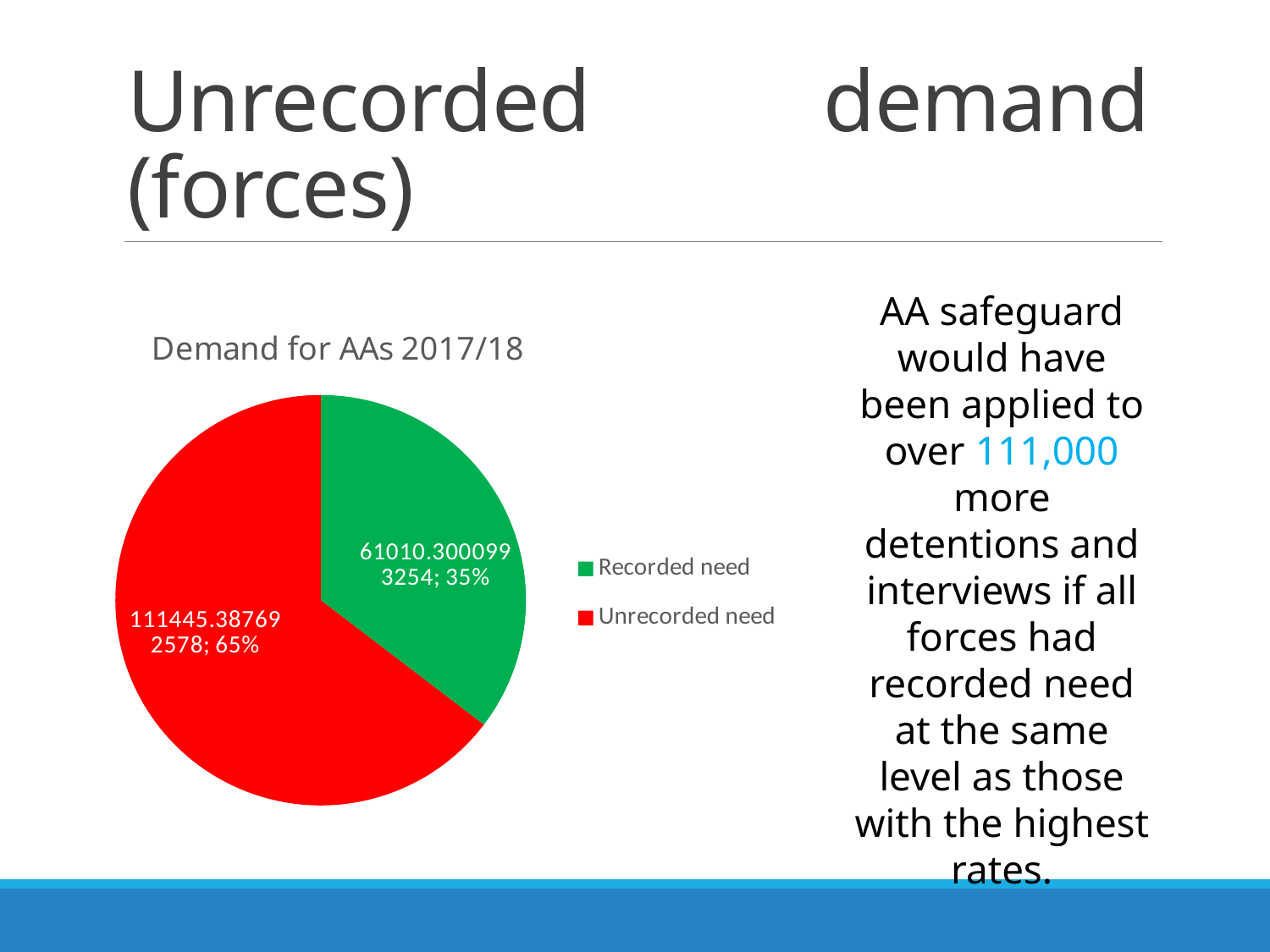
Which slice is the smallest in the pie chart? Recorded need What kind of chart is shown on the slide? pie chart What is the title of the chart? Demand for AAs 2017/18 How many slices does the pie chart have? 2 Which is larger, Recorded need or Unrecorded need? Unrecorded need What share of the pie does Unrecorded need represent? 65% What value is shown for Recorded need? 61010.3000993254 What value is shown for Unrecorded need? 111445.387692578 What colour is the Recorded need slice? green What share of the pie does Recorded need represent? 35% Which slice is the largest in the pie chart? Unrecorded need How many entries does the chart legend list? 2